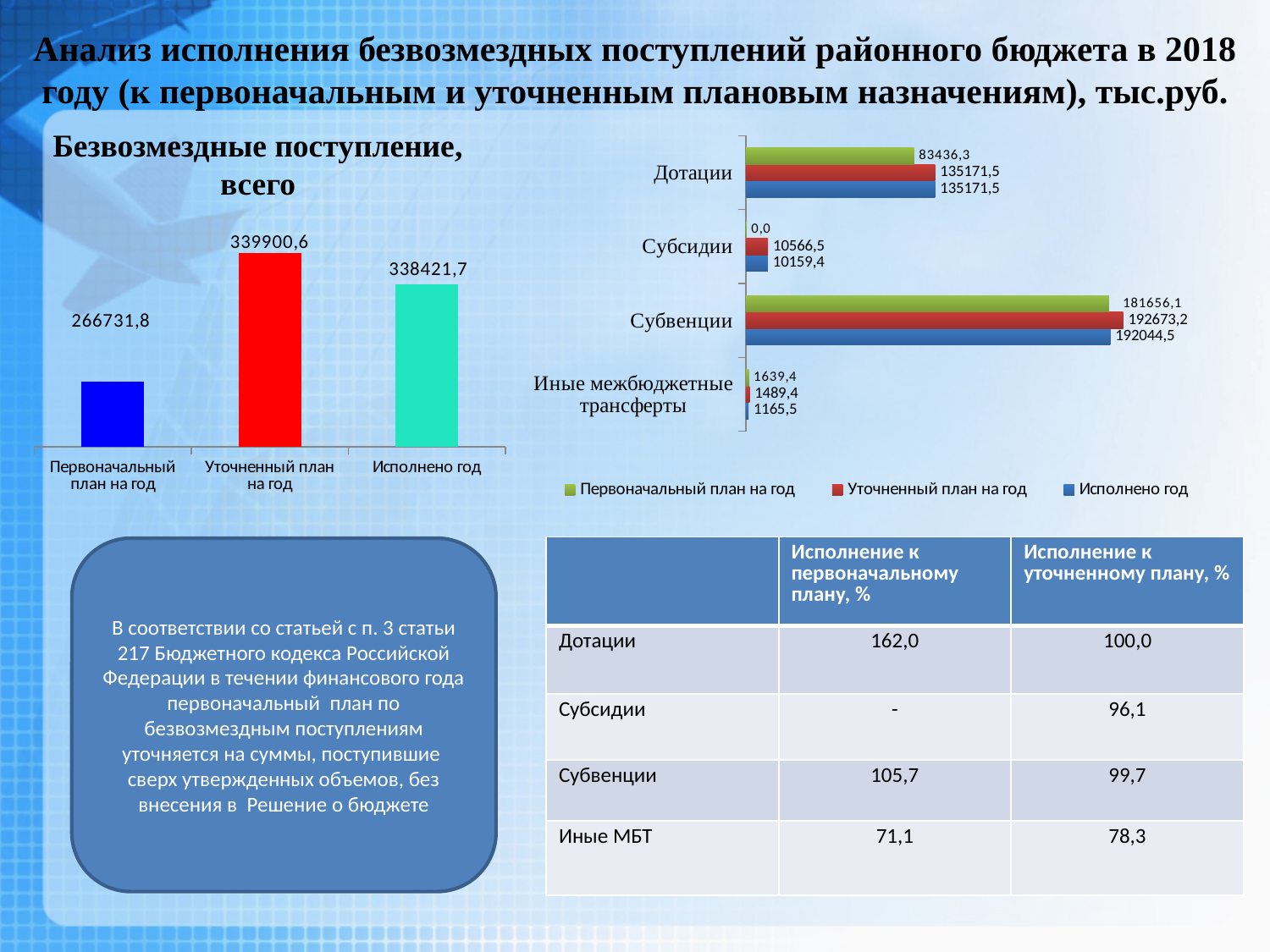
What kind of chart is the chart on the right side of the slide? bar chart In the chart titled "Безвозмездные поступление, всего", which category has the lowest value? Первоначальный план на год In the chart on the right side of the slide, what is the difference between the "Уточненный план на год" and "Первоначальный план на год" values for "Дотации"? 51735,2 In the chart on the right side of the slide, how many series does the legend list? 3 In the chart on the right side of the slide, which colour represents the "Исполнено год" series? blue In the chart titled "Безвозмездные поступление, всего", what is the difference between "Уточненный план на год" and "Первоначальный план на год"? 73168,8 In the chart on the right side of the slide, what is the "Исполнено год" value for "Субвенции"? 192044,5 In the chart titled "Безвозмездные поступление, всего", how many bars are plotted? 3 In the chart on the right side of the slide, what is the "Первоначальный план на год" value for "Субсидии"? 0,0 In the chart on the right side of the slide, which is larger for "Иные межбюджетные трансферты": "Первоначальный план на год" or "Исполнено год"? Первоначальный план на год In the chart titled "Безвозмездные поступление, всего", what is the value for "Уточненный план на год"? 339900,6 In the chart on the right side of the slide, which category has the highest "Уточненный план на год" value? Субвенции